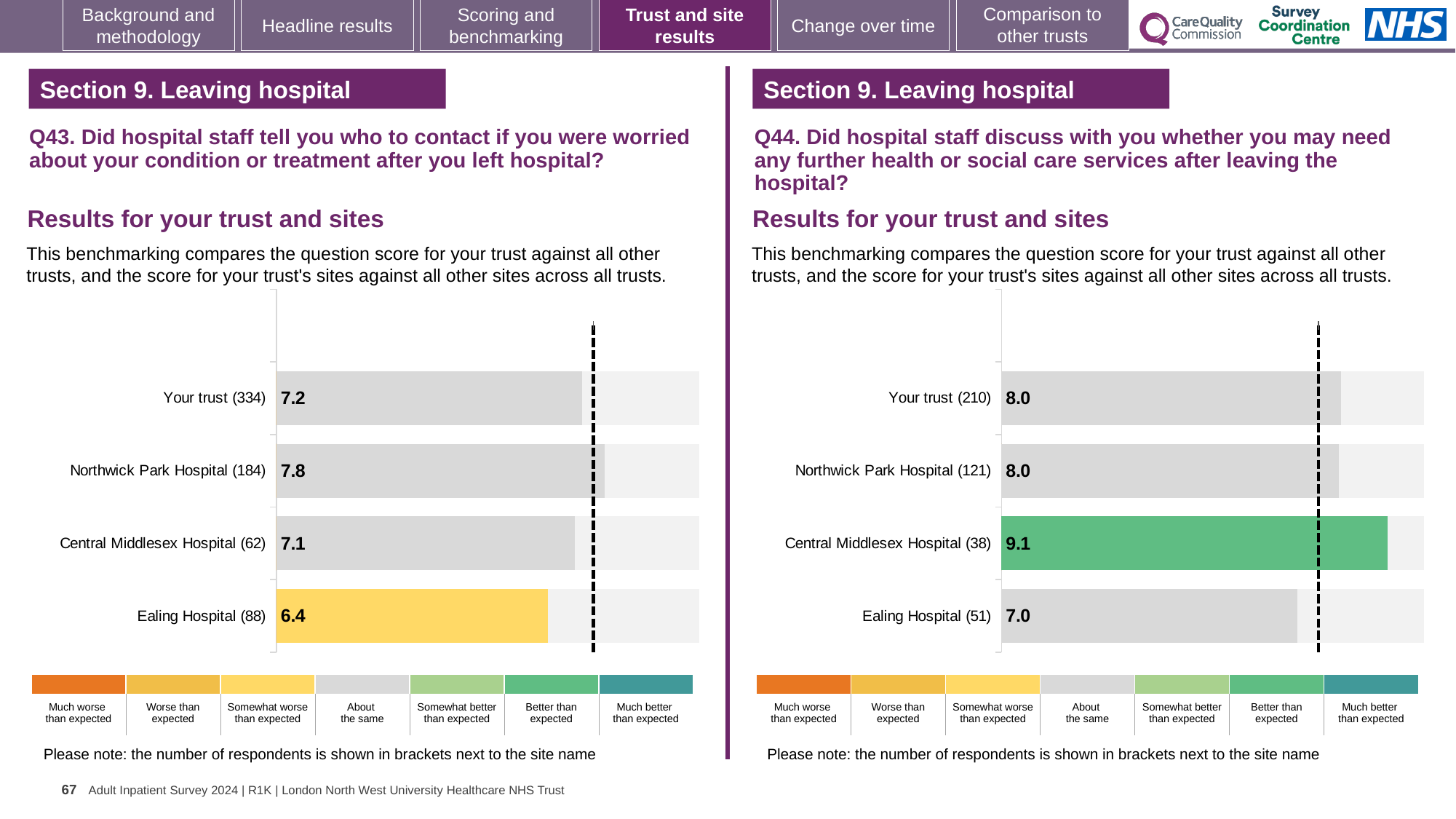
In the Q43 chart on the left, what is the score for Northwick Park Hospital? 7.8 In the Q43 chart on the left, what is the difference between the scores for Northwick Park Hospital and Ealing Hospital? 1.4 In the Q44 chart on the right, which site or trust has the lowest score? Ealing Hospital What type of chart is used for the Q43 results on the left? Bar chart In the Q44 chart on the right, what is the difference between the scores for Central Middlesex Hospital and Ealing Hospital? 2.1 In the Q44 chart on the right, what is the score for Central Middlesex Hospital? 9.1 In the Q44 chart on the right, which site's bar is coloured green? Central Middlesex Hospital In the Q43 chart on the left, what is the score for Ealing Hospital? 6.4 In the Q43 chart on the left, which site or trust has the highest score? Northwick Park Hospital How many bars are plotted in the Q44 chart on the right? 4 In the Q44 chart on the right, what is the score for Your trust? 8.0 In the Q43 chart on the left, which has the higher score, Your trust or Central Middlesex Hospital? Your trust